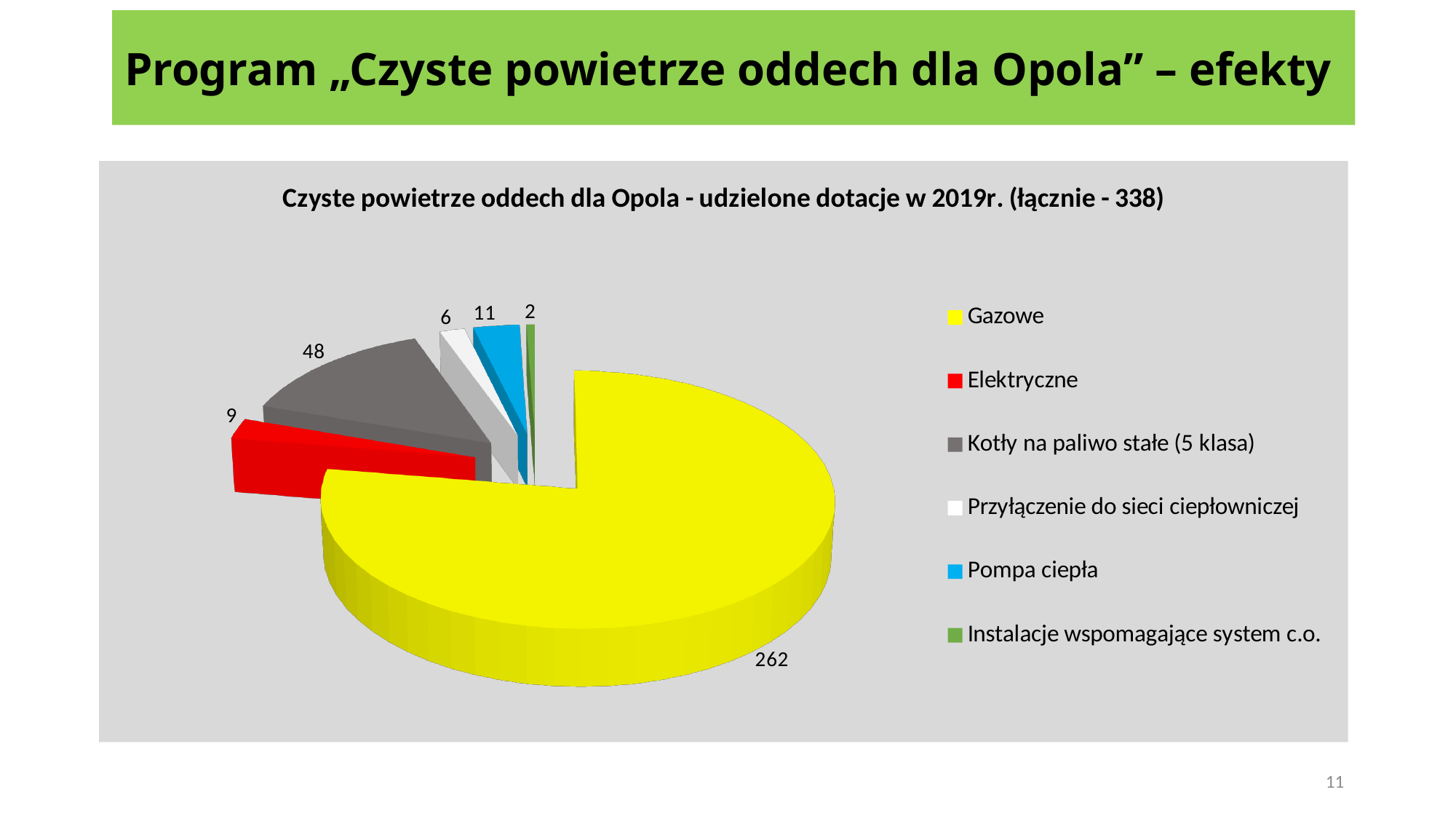
Which is larger, the value for Pompa ciepła or the value for Przyłączenie do sieci ciepłowniczej? Pompa ciepła Which category has the smallest slice? Instalacje wspomagające system c.o. How many categories does the pie chart have? 6 Which category has the largest slice? Gazowe What is the total number of grants stated in the chart title? 338 What is the difference between the values for Gazowe and Kotły na paliwo stałe (5 klasa)? 214 What is the value for Elektryczne? 9 What type of chart is shown on the slide? Pie chart What is the value for Gazowe? 262 What colour is the slice for Elektryczne? Red What is the value for Pompa ciepła? 11 What is the value for Kotły na paliwo stałe (5 klasa)? 48